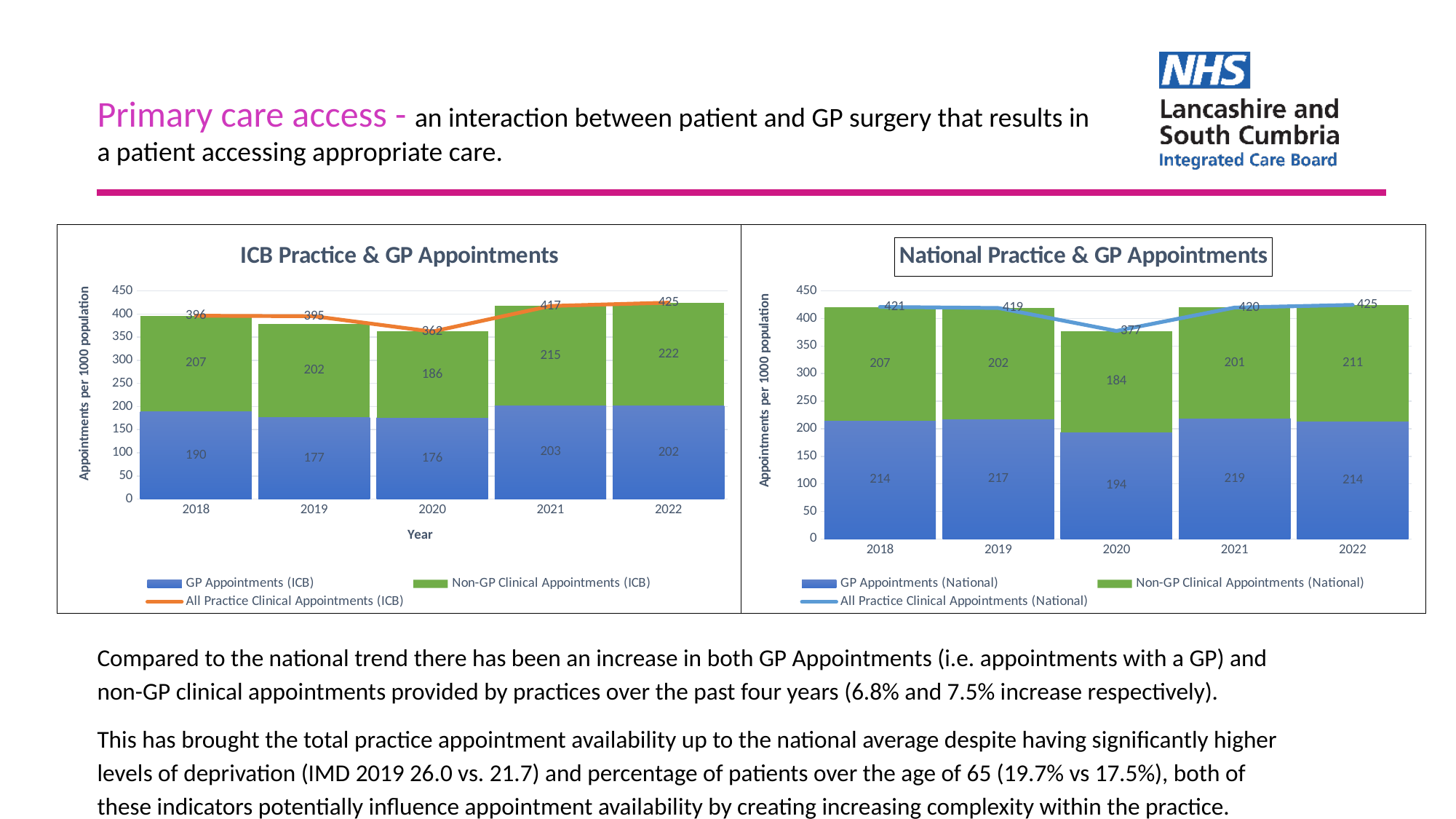
In the ICB Practice & GP Appointments chart, what is the difference between the Non-GP Clinical Appointments (ICB) values for 2022 and 2020? 36 In the ICB Practice & GP Appointments chart, what is the value of Non-GP Clinical Appointments (ICB) for 2020? 186 What kind of chart is the ICB Practice & GP Appointments chart? Stacked bar chart with a line In the ICB Practice & GP Appointments chart, what is the value of GP Appointments (ICB) for 2021? 203 In the National Practice & GP Appointments chart, is the Non-GP Clinical Appointments (National) value for 2019 or for 2022 larger? 2022 In the ICB Practice & GP Appointments chart, what is the All Practice Clinical Appointments (ICB) value for 2022? 425 How many years are shown on the x axis of the ICB Practice & GP Appointments chart? 5 In the National Practice & GP Appointments chart, which year has the highest GP Appointments (National) value? 2021 In the National Practice & GP Appointments chart, what is the All Practice Clinical Appointments (National) value for 2018? 421 In the National Practice & GP Appointments chart, what is the value of GP Appointments (National) for 2020? 194 How many series does the legend of the National Practice & GP Appointments chart list? 3 In the ICB Practice & GP Appointments chart, which year has the lowest All Practice Clinical Appointments (ICB) value? 2020